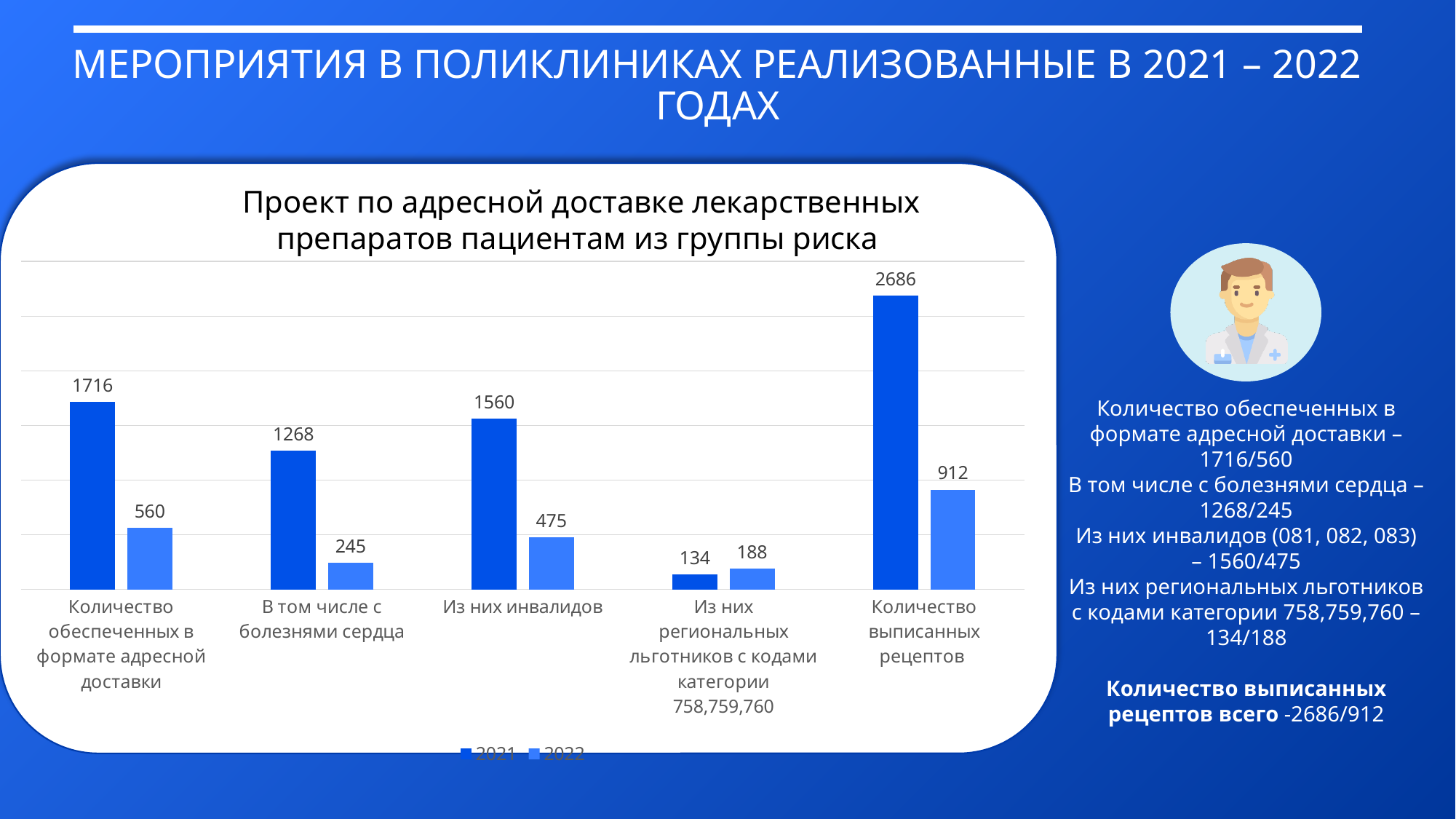
For "Из них региональных льготников с кодами категории 758,759,760", which year has the larger value, 2021 or 2022? 2022 What is the difference between the 2021 and 2022 values for "Количество обеспеченных в формате адресной доставки"? 1156 Which category has the lowest 2022 value? Из них региональных льготников с кодами категории 758,759,760 Which category has the highest 2021 value? Количество выписанных рецептов What type of chart is shown on the slide? Bar chart What is the 2022 value for "Из них инвалидов"? 475 What is the title of the chart? Проект по адресной доставке лекарственных препаратов пациентам из группы риска What is the 2021 value for "Количество выписанных рецептов"? 2686 What is the 2021 value for "В том числе с болезнями сердца"? 1268 How many series does the chart's legend list? 2 Which is larger: the 2022 value for "Количество обеспеченных в формате адресной доставки" or the 2022 value for "Из них инвалидов"? Количество обеспеченных в формате адресной доставки How many categories are shown on the x axis of the chart? 5